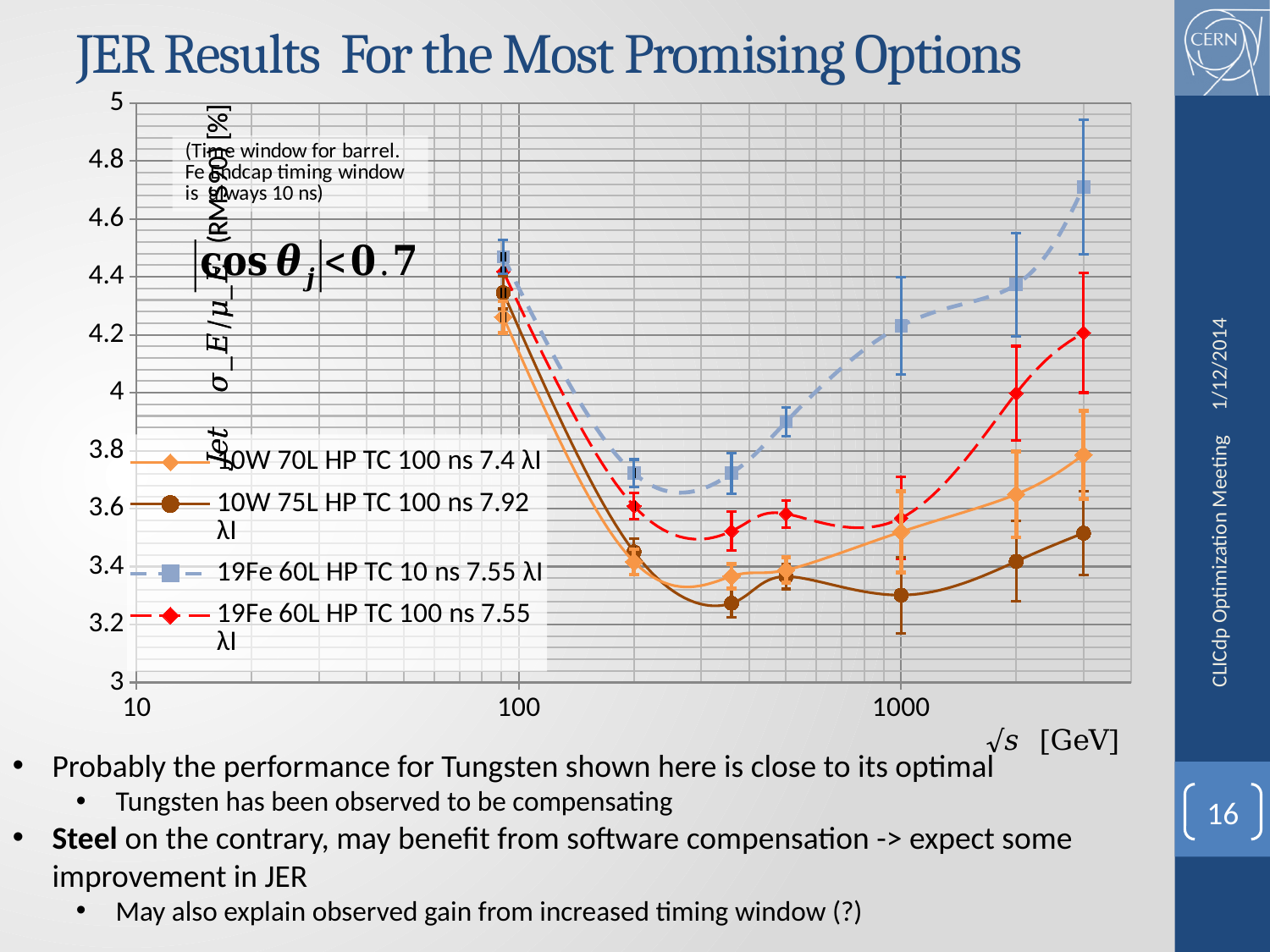
Is the value of the 19Fe 60L HP TC 10 ns 7.55 λI series at 1000 GeV greater or less than 4? greater What colour is the 19Fe 60L HP TC 100 ns 7.55 λI series drawn in? red What kind of chart is shown on the slide? line chart Which series has the lowest value at the rightmost data point (around 3000 GeV)? 10W 75L HP TC 100 ns 7.92 λI Does the 19Fe 60L HP TC 10 ns 7.55 λI series rise or fall between 200 GeV and 3000 GeV? rise Is the value of the 10W 75L HP TC 100 ns 7.92 λI series at its rightmost point greater or less than 4? less Is the value of the 19Fe 60L HP TC 10 ns 7.55 λI series at its rightmost point greater or less than 4.4? greater At the rightmost data point, which series has the larger value: 19Fe 60L HP TC 10 ns 7.55 λI or 10W 75L HP TC 100 ns 7.92 λI? 19Fe 60L HP TC 10 ns 7.55 λI Which series has the highest value at the rightmost data point (around 3000 GeV)? 19Fe 60L HP TC 10 ns 7.55 λI What is the x-axis label of the chart? √s [GeV] How many series does the chart legend list? 4